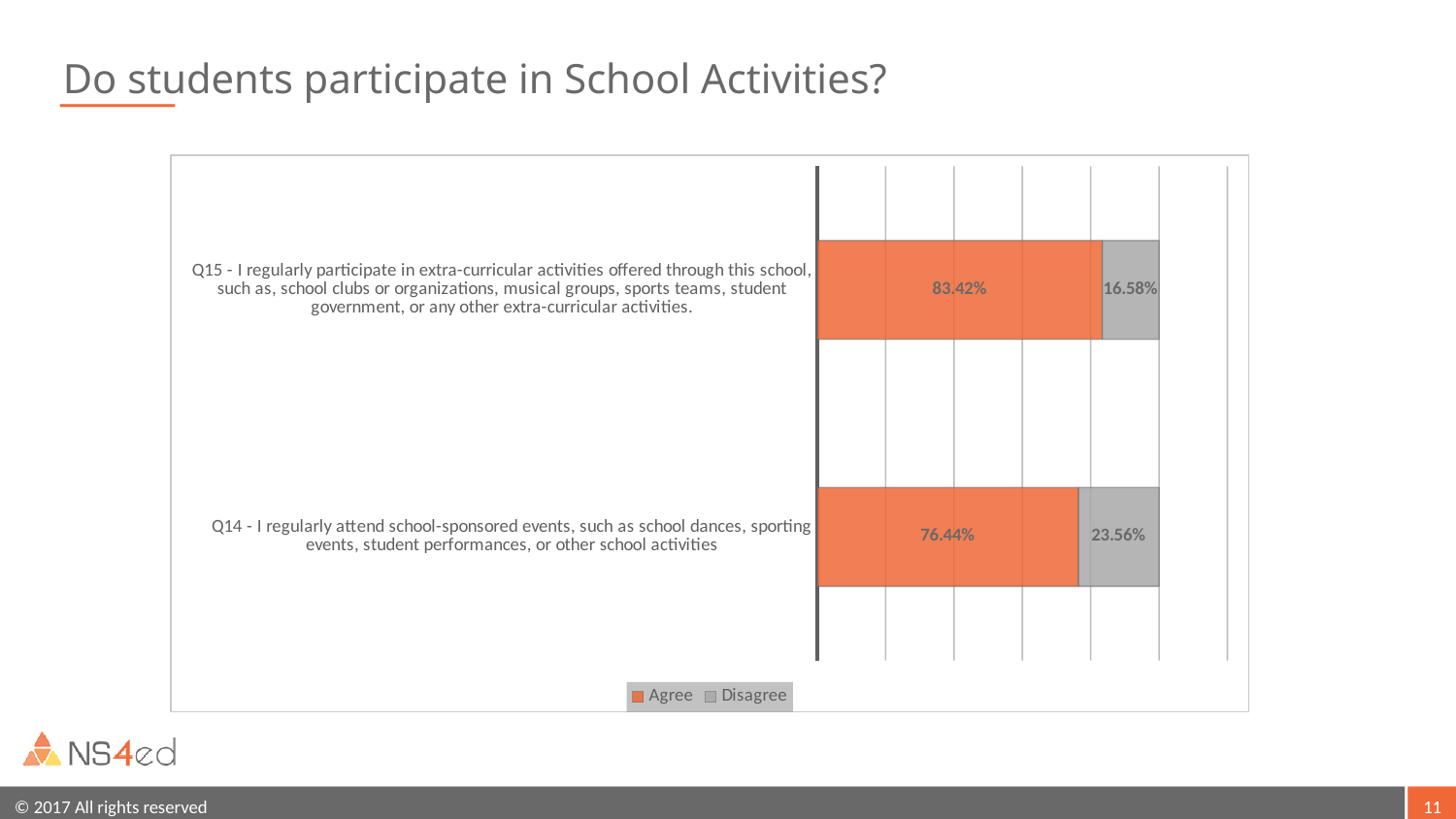
How many series does the legend list? 2 Which question has the lowest Disagree percentage? Q15 Which colour represents the Agree series in the chart? Orange What percentage of students disagree with Q14 (regularly attend school-sponsored events)? 23.56% What is the total of the Agree and Disagree segments for the Q14 bar? 100% What is the Disagree value for Q15? 16.58% What is the Agree value for Q14? 76.44% What type of chart is shown on the slide? Stacked bar chart How many questions (categories) are shown in the chart? 2 Which question has the higher Agree percentage, Q14 or Q15? Q15 What percentage of students agree with Q15 (regularly participate in extra-curricular activities)? 83.42% What is the difference between the Agree percentages for Q15 and Q14? 6.98%